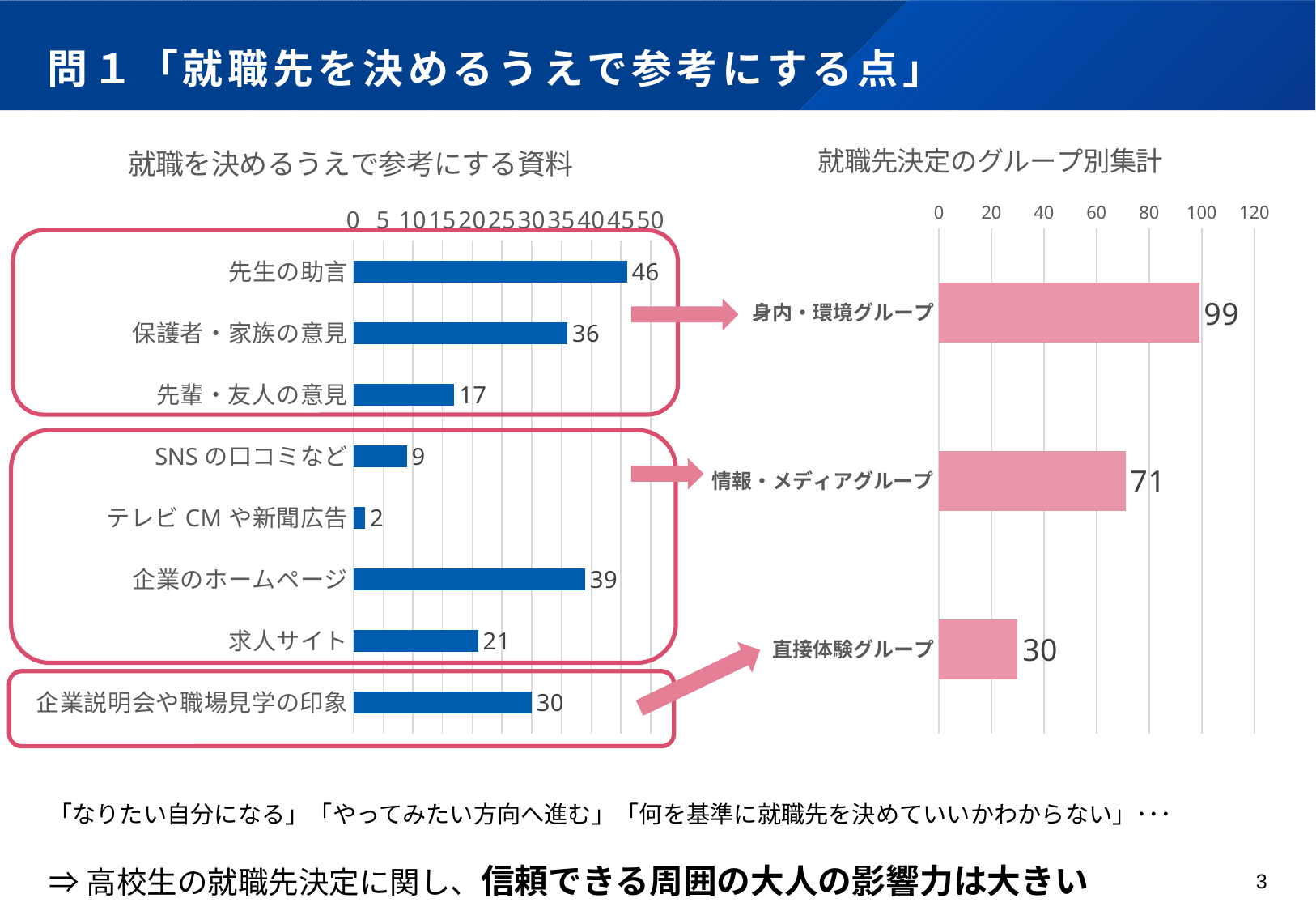
In the chart titled 就職を決めるうえで参考にする資料, which is larger: 求人サイト or 企業説明会や職場見学の印象? 企業説明会や職場見学の印象 What kind of chart is the chart titled 就職先決定のグループ別集計? Bar chart In the chart titled 就職を決めるうえで参考にする資料, what is the difference between 保護者・家族の意見 and 先輩・友人の意見? 19 In the chart titled 就職先決定のグループ別集計, is the value for 身内・環境グループ greater or less than 100? less In the chart titled 就職先決定のグループ別集計, what is the value for 情報・メディアグループ? 71 In the chart titled 就職を決めるうえで参考にする資料, which category has the highest value? 先生の助言 In the chart titled 就職を決めるうえで参考にする資料, what is the value for 先生の助言? 46 In the chart titled 就職先決定のグループ別集計, what is the difference between 身内・環境グループ and 直接体験グループ? 69 In the chart titled 就職を決めるうえで参考にする資料, which category has the lowest value? テレビCMや新聞広告 In the chart titled 就職を決めるうえで参考にする資料, what is the value for 企業のホームページ? 39 How many categories are shown in the chart titled 就職を決めるうえで参考にする資料? 8 In the chart titled 就職先決定のグループ別集計, which group has the highest value? 身内・環境グループ